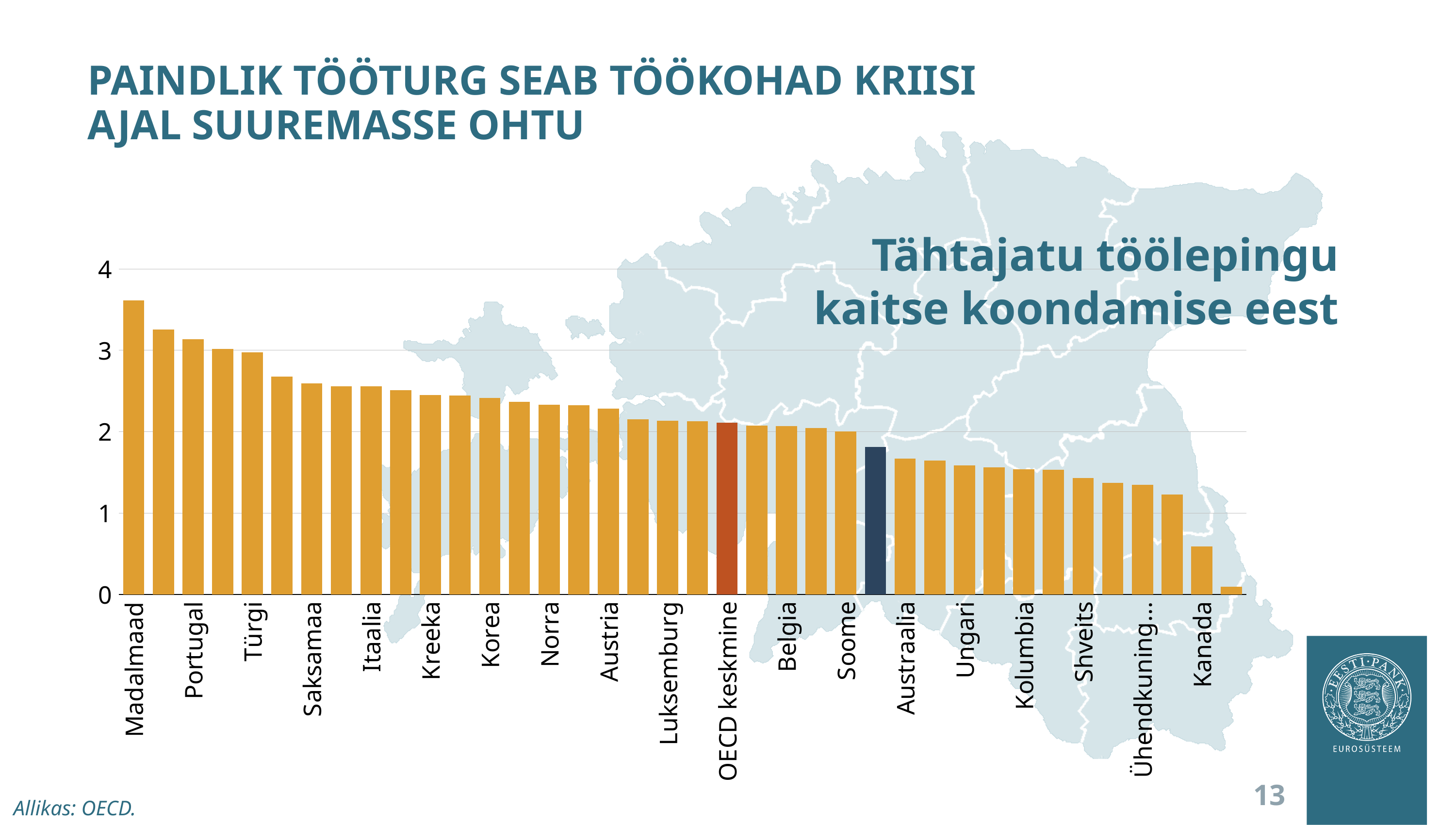
Which has a larger value, Shveits or Kanada? Shveits Is the value for Ungari greater or less than 2? less Is the value for Kanada greater or less than 1? less Is the value for Saksamaa greater or less than 2? greater Which has a larger value, Portugal or Belgia? Portugal What kind of chart is shown on the slide? Bar chart Do the bar values rise or fall from left to right along the x axis? Fall Which category has the highest value in the chart? Madalmaad What is the title shown on the chart? Tähtajatu töölepingu kaitse koondamise eest What is the source cited for the chart? OECD